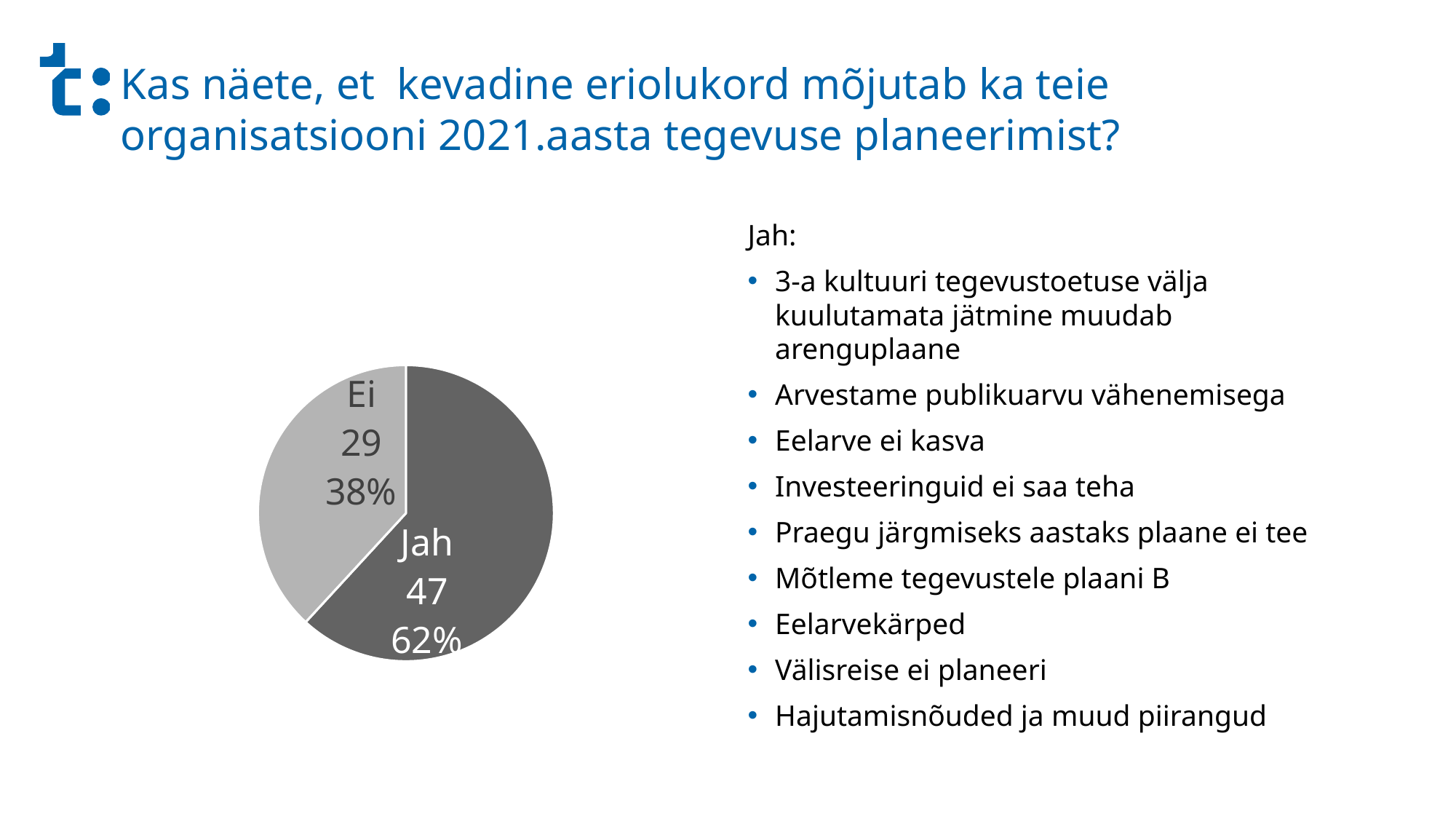
What kind of chart is shown on the slide? Pie chart Which slice is the smallest in the pie chart? Ei How many slices does the pie chart have? 2 Which is larger, the "Jah" slice or the "Ei" slice? Jah Which slice is shown in the darker grey colour? Jah Which slice is the largest in the pie chart? Jah What percentage share does the "Ei" slice have? 38% What is the difference between the "Jah" and "Ei" values? 18 What percentage share does the "Jah" slice have? 62% What is the value for the "Jah" slice? 47 What is the value for the "Ei" slice? 29 What is the total of the two slice values in the pie chart? 76